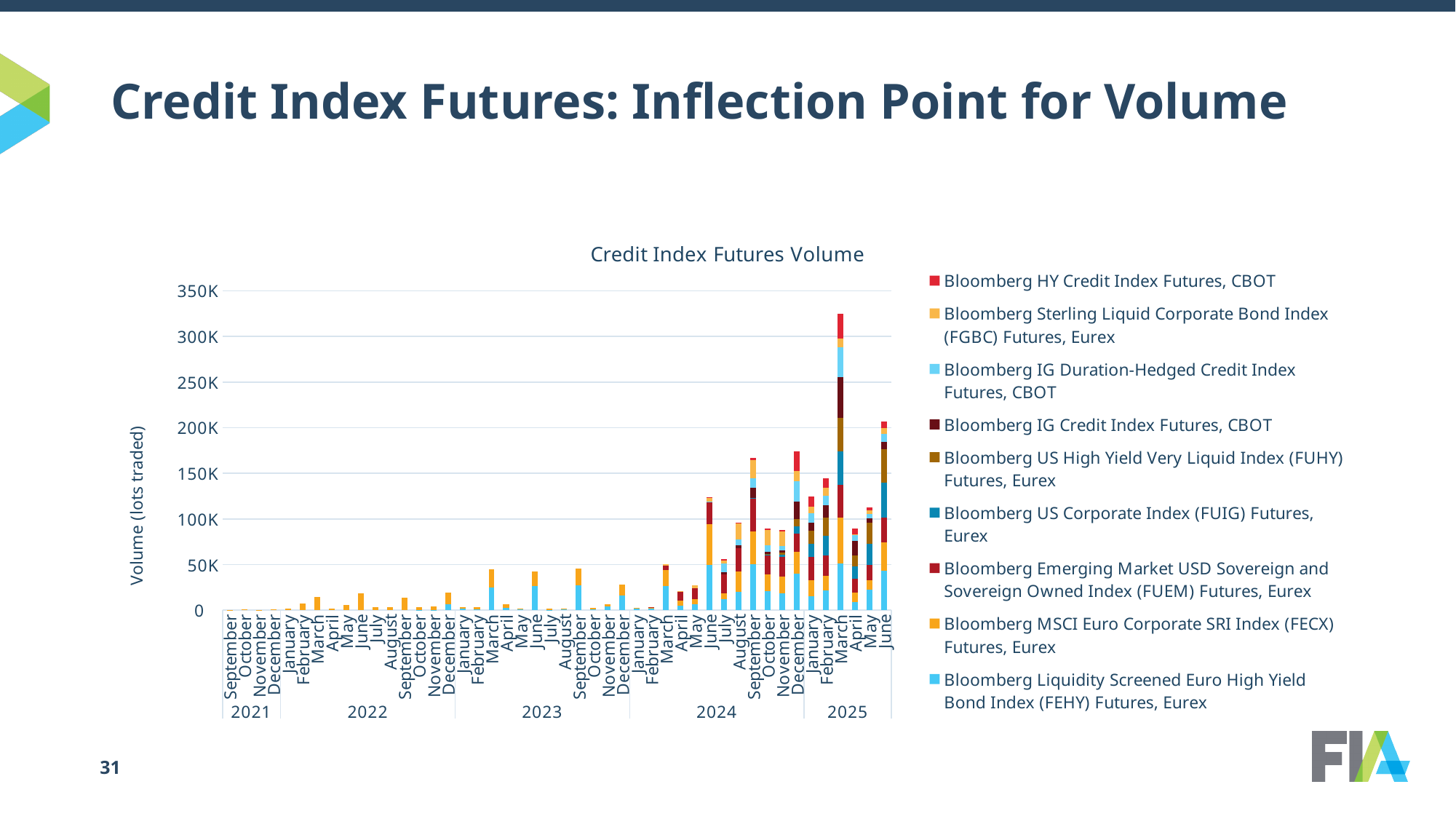
Is the total volume for March 2022 greater or less than 50K? less How many years are labelled along the x axis of the chart? 5 Which month has the larger total volume, September 2024 or October 2024? September 2024 Which month has the highest total volume in the Credit Index Futures Volume chart? March 2025 Is the total volume for March 2025 greater or less than 300K? greater Is the total volume for June 2024 greater or less than 100K? greater Overall, do the monthly volumes rise or fall from 2021 to 2025 in the chart? Rise How many series does the legend of the Credit Index Futures Volume chart list? 9 What is the label of the vertical axis of the chart? Volume (lots traded) Which month has the larger total volume, March 2025 or June 2025? March 2025 What kind of chart is shown on the slide? Stacked bar chart